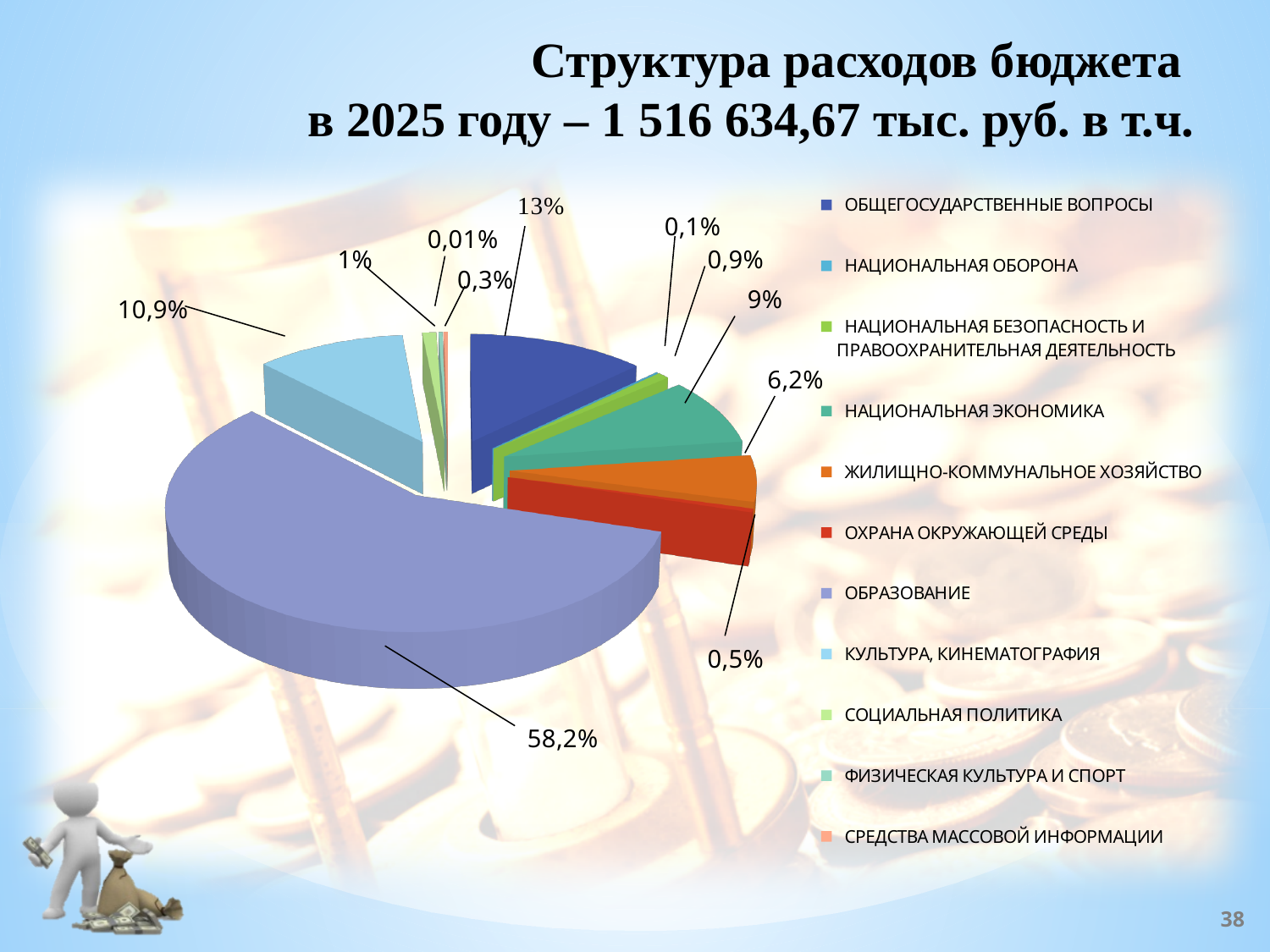
What share of the budget expenditure goes to ОБРАЗОВАНИЕ? 58,2% What is the smallest percentage label shown on the pie chart? 0,01% What share is shown for КУЛЬТУРА, КИНЕМАТОГРАФИЯ? 10,9% What share is shown for ОБЩЕГОСУДАРСТВЕННЫЕ ВОПРОСЫ? 13% How many categories does the legend list? 11 What share is shown for НАЦИОНАЛЬНАЯ ЭКОНОМИКА? 9% Which category has the largest share of the budget expenditure? ОБРАЗОВАНИЕ What share is shown for ЖИЛИЩНО-КОММУНАЛЬНОЕ ХОЗЯЙСТВО? 6,2% Which has a larger share: НАЦИОНАЛЬНАЯ ЭКОНОМИКА or ЖИЛИЩНО-КОММУНАЛЬНОЕ ХОЗЯЙСТВО? НАЦИОНАЛЬНАЯ ЭКОНОМИКА What kind of chart is shown on the slide? pie chart What total budget expenditure amount for 2025 is stated in the slide title? 1 516 634,67 тыс. руб. What is the difference between the shares of ОБРАЗОВАНИЕ and КУЛЬТУРА, КИНЕМАТОГРАФИЯ? 47,3%